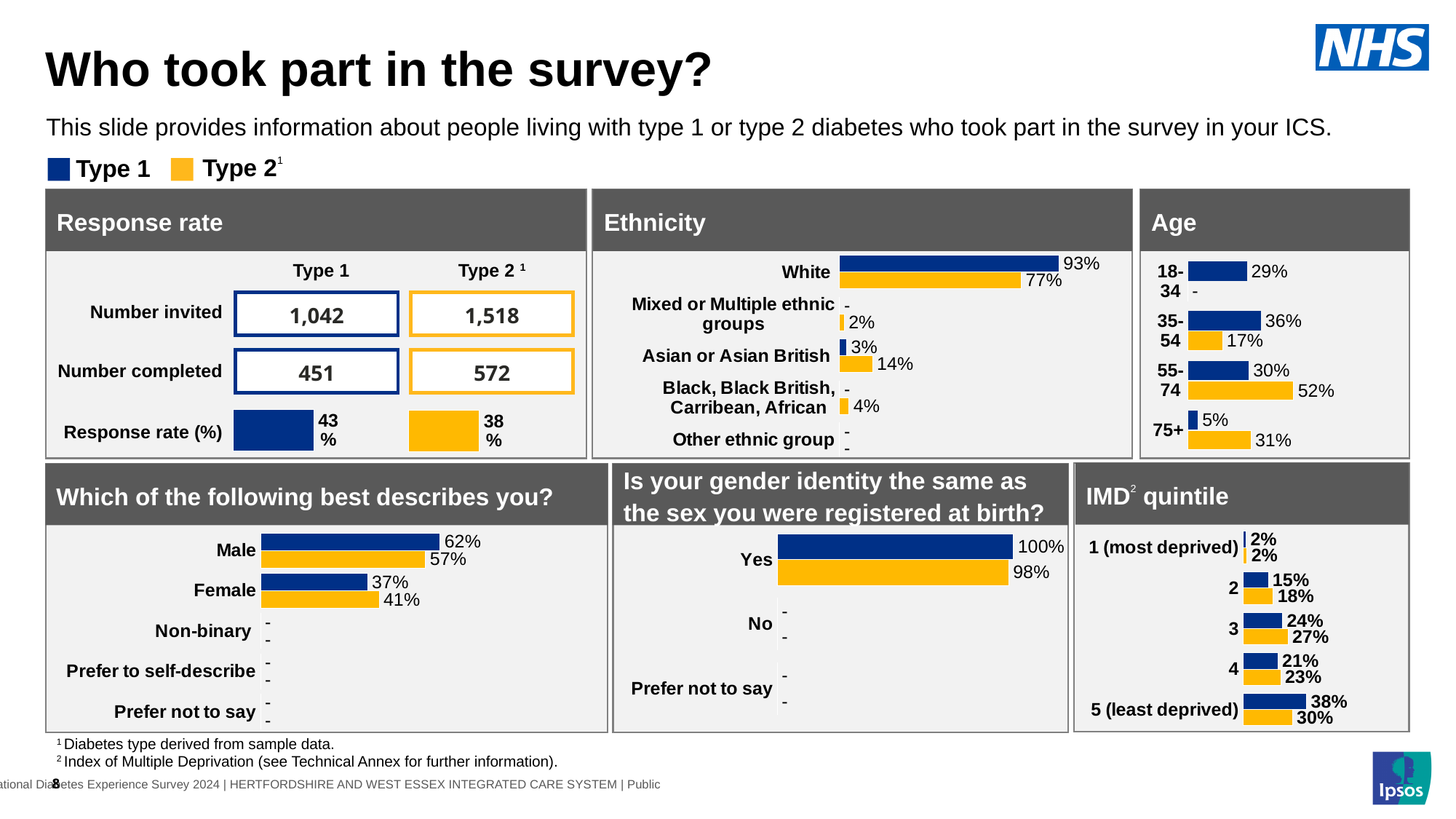
In the Age chart, what is the difference between the Type 1 and Type 2 percentages for the 75+ group? 26% How many series does the legend at the top of the slide list? 2 In the Ethnicity chart, what percentage of Type 2 respondents are Asian or Asian British? 14% In the Response rate chart, what is the number completed for Type 2? 572 In the Ethnicity chart, what percentage of Type 1 respondents are White? 93% In the IMD quintile chart, which quintile has the highest Type 1 percentage? 5 (least deprived) In the Age chart, which age group has the highest Type 2 percentage? 55-74 In the 'Which of the following best describes you?' chart, what percentage of Type 2 respondents are Female? 41% In the IMD quintile chart, what is the difference between the Type 2 and Type 1 percentages for quintile 3? 3% In the Response rate chart, which type has the higher response rate, Type 1 or Type 2? Type 1 In the 'Which of the following best describes you?' chart, how many categories are listed? 5 In the gender identity chart, what percentage of Type 1 respondents answered Yes? 100%